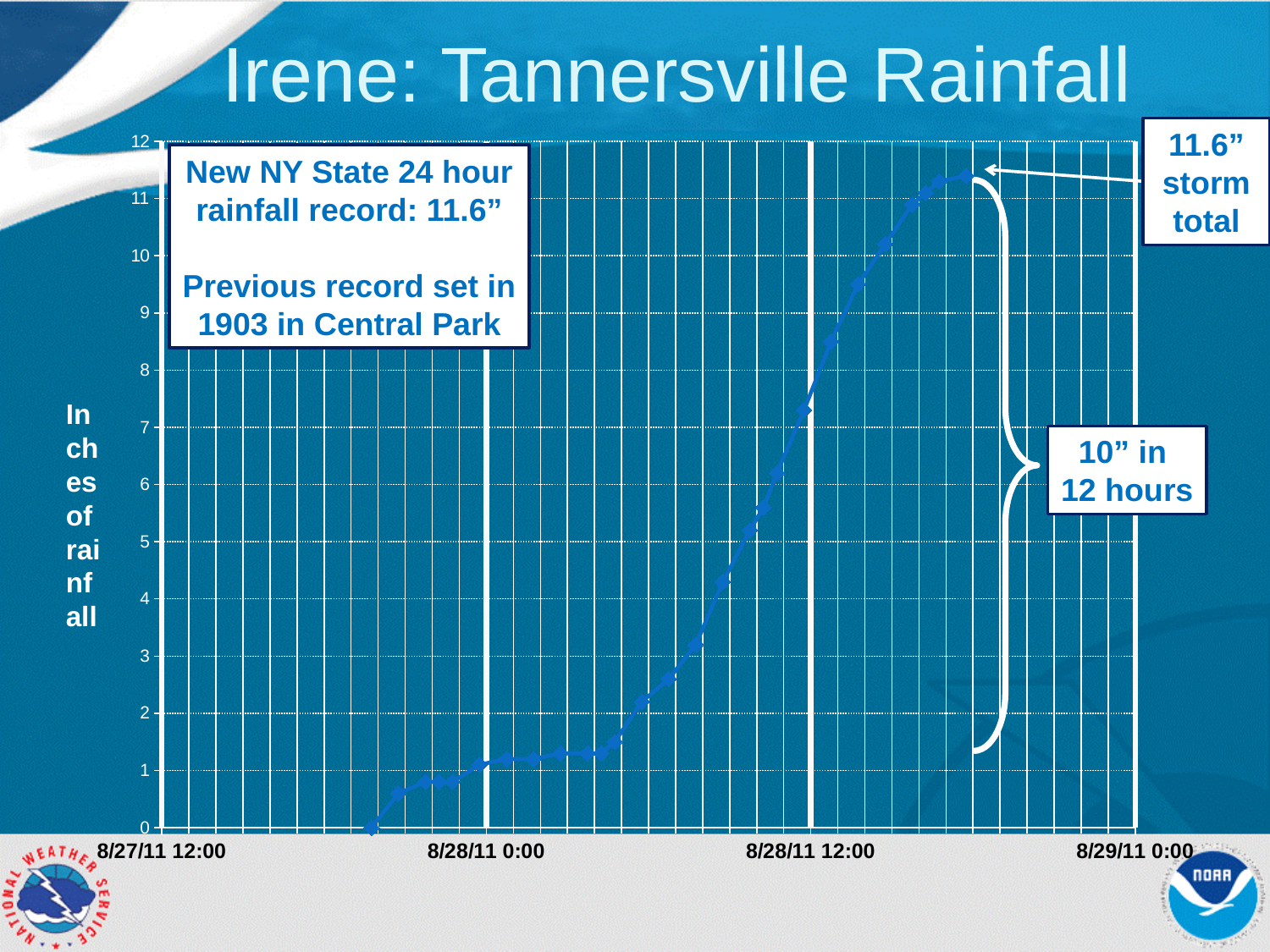
Does the plotted rainfall line rise or fall from 8/27/11 12:00 to 8/29/11 0:00? rise Is the rainfall value at 8/28/11 0:00 greater or less than 2 inches? less What is the storm total rainfall shown in the annotation on the chart? 11.6" How many date/time labels are shown along the x axis? 4 According to the annotation, how much rain fell in 12 hours? 10" Is the rainfall value at 8/28/11 12:00 greater or less than 10 inches? less What is the title of the chart? Irene: Tannersville Rainfall Which is larger: the rainfall at 8/28/11 0:00 or the rainfall at 8/28/11 12:00? 8/28/11 12:00 What is the new NY State 24 hour rainfall record stated on the chart? 11.6" What is the highest value shown on the y axis of the chart? 12 Is the rainfall value at 8/28/11 12:00 greater or less than 6 inches? greater What kind of chart is shown on the slide? line chart